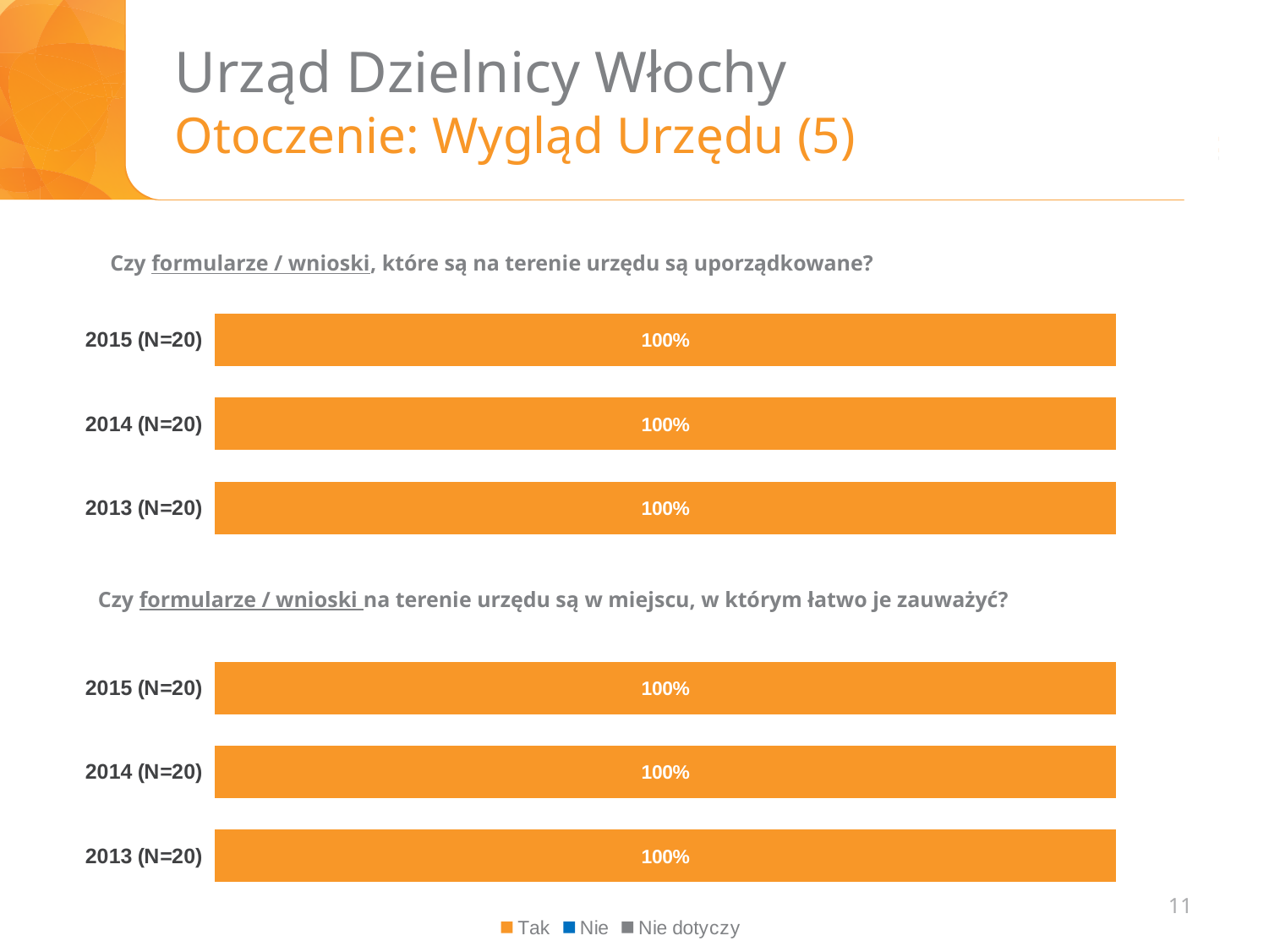
Which legend entry is shown in orange? Tak In the top chart, what is the difference between the values for 2015 (N=20) and 2013 (N=20)? 0% How many categories (years) are shown in the bottom chart? 3 In the bottom chart ("Czy formularze / wnioski na terenie urzędu są w miejscu, w którym łatwo je zauważyć?"), what is the value for 2014 (N=20)? 100% What are the three legend entries listed at the bottom of the slide? Tak, Nie, Nie dotyczy What kind of chart is the top chart? Bar chart In the bottom chart ("Czy formularze / wnioski na terenie urzędu są w miejscu, w którym łatwo je zauważyć?"), what is the value for 2015 (N=20)? 100% In the bottom chart, do the values change from 2013 to 2015? No, they stay at 100% How many series does the legend at the bottom of the slide list? 3 In the top chart ("Czy formularze / wnioski, które są na terenie urzędu są uporządkowane?"), what is the value for 2013 (N=20)? 100% How many categories (years) are shown in the top chart? 3 In the top chart ("Czy formularze / wnioski, które są na terenie urzędu są uporządkowane?"), what is the value for 2015 (N=20)? 100%